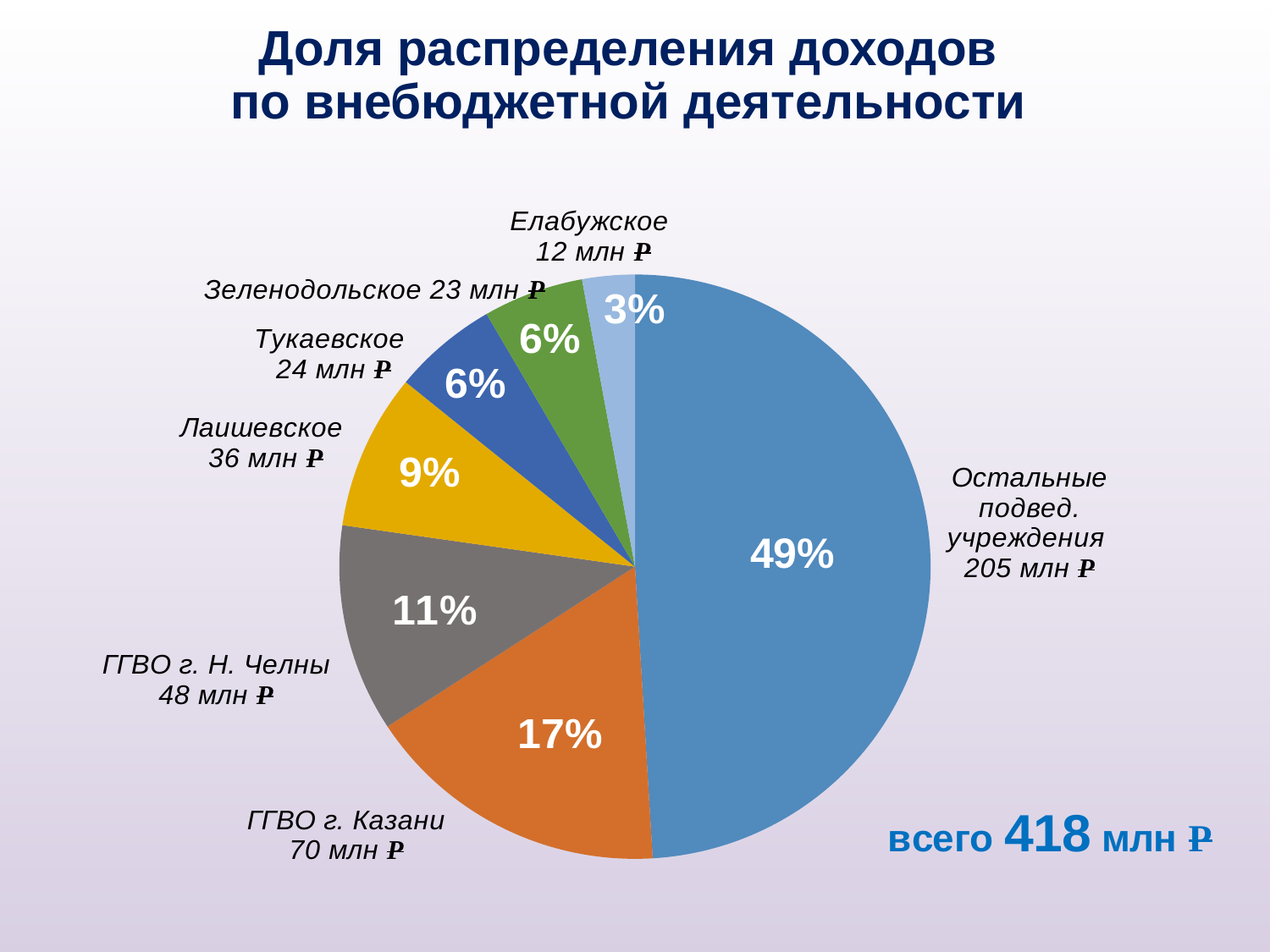
Which category has the largest slice of the pie? Остальные подвед. учреждения What total amount is stated on the slide for all categories? 418 млн ₽ What share of the pie does Лаишевское hold? 9% What is the value shown for Тукаевское? 24 млн ₽ What share of the pie does ГГВО г. Казани hold? 17% What is the title of the chart? Доля распределения доходов по внебюджетной деятельности Which is larger, the value for Лаишевское or the value for Зеленодольское? Лаишевское Which category has the smallest slice of the pie? Елабужское What is the difference in value between ГГВО г. Казани and ГГВО г. Н. Челны? 22 млн ₽ What is the value shown for ГГВО г. Н. Челны? 48 млн ₽ What kind of chart is shown on the slide? pie chart How many slices does the pie chart have? 7